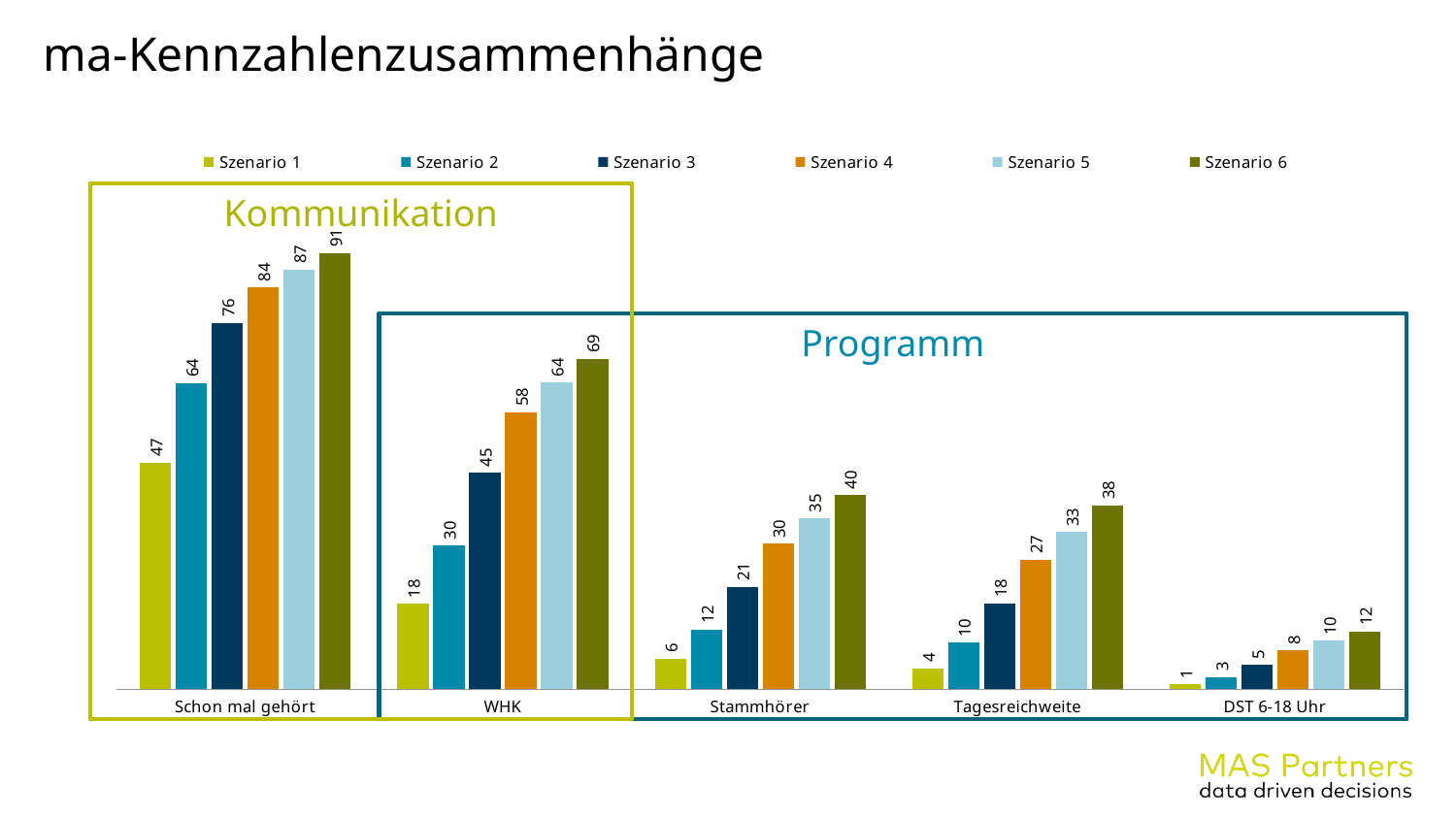
What is the value for Szenario 1 in the 'Schon mal gehört' category? 47 What is the difference between Szenario 6 and Szenario 1 in the 'Schon mal gehört' category? 44 What kind of chart is shown on the slide? Bar chart How many series does the legend list? 6 Which is larger: Szenario 5 in 'WHK' or Szenario 5 in 'Stammhörer'? Szenario 5 in WHK Which categories are grouped under the 'Kommunikation' box? Schon mal gehört and WHK Which category has the highest value for Szenario 6? Schon mal gehört What is the value for Szenario 4 in the 'Stammhörer' category? 30 What is the value for Szenario 3 in the 'Tagesreichweite' category? 18 What is the value for Szenario 6 in the 'WHK' category? 69 How many categories are shown on the x axis? 5 Which category has the lowest value for Szenario 1? DST 6-18 Uhr